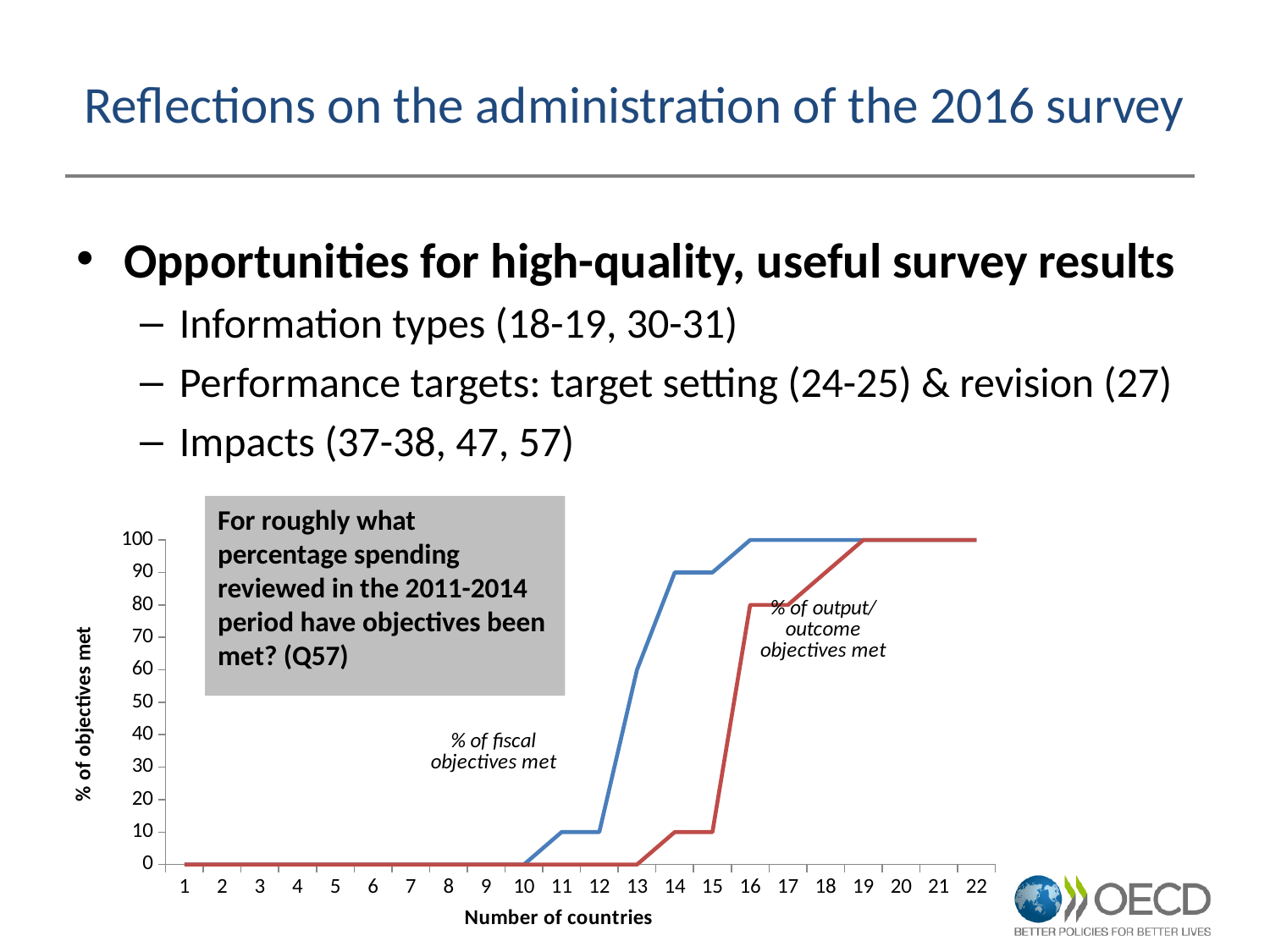
What is the value of '% of output/outcome objectives met' at 14 countries? 10 Is the value for '% of fiscal objectives met' at 13 countries greater or less than 50? greater What is the value of '% of fiscal objectives met' at 14 countries? 90 At 14 countries, which series has the larger value: '% of fiscal objectives met' or '% of output/outcome objectives met'? % of fiscal objectives met What type of chart is shown on the slide? line chart How many series (lines) are plotted on the chart? 2 What is the difference between '% of fiscal objectives met' and '% of output/outcome objectives met' at 14 countries? 80 What is the title of the x axis of the chart? Number of countries What is the value of '% of output/outcome objectives met' at 16 countries? 80 Do the values of '% of fiscal objectives met' rise or fall as the number of countries increases? rise What is the value of '% of fiscal objectives met' at 11 countries? 10 How many points are shown along the x axis (Number of countries)? 22